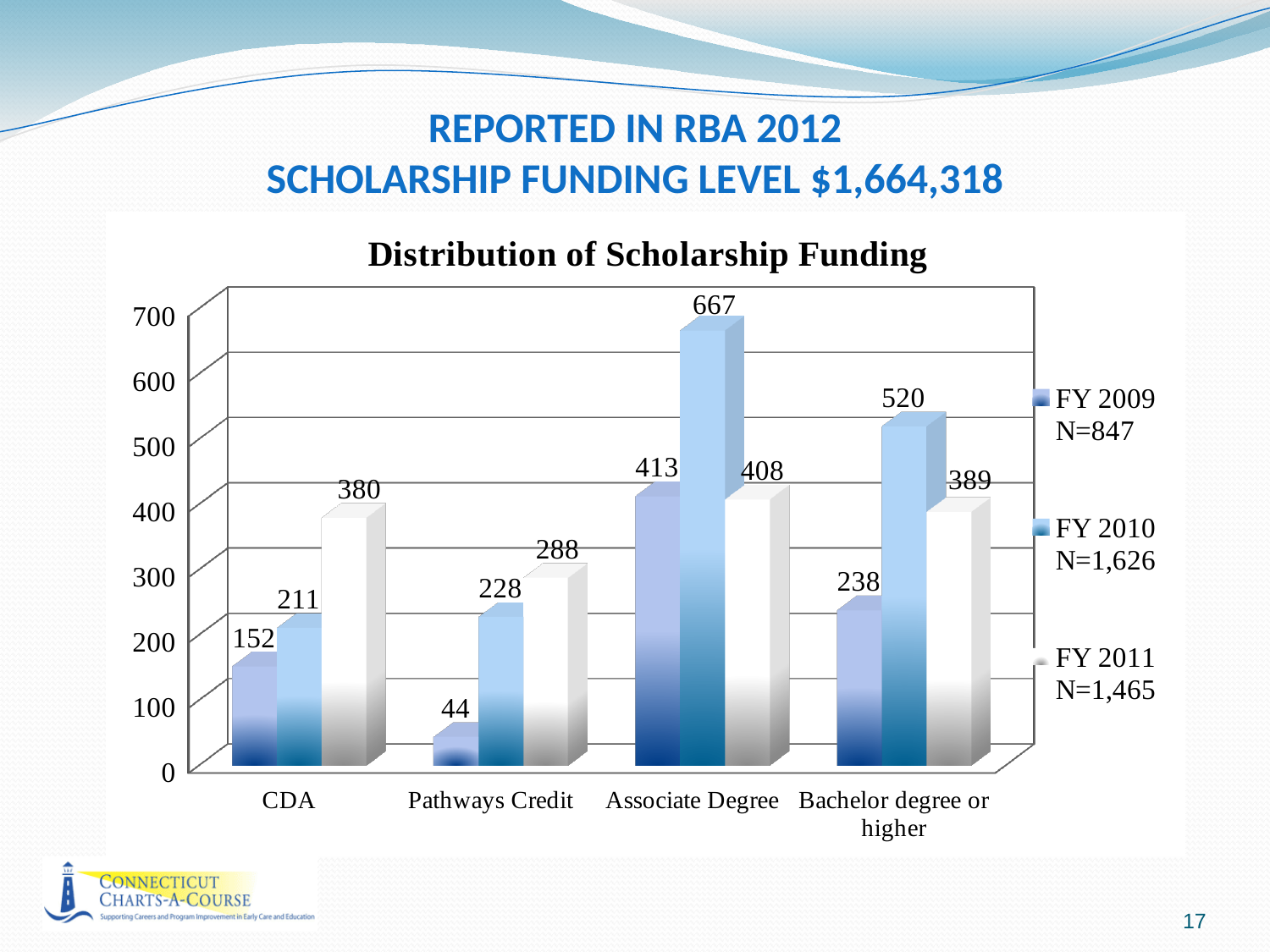
What is the FY 2009 value for Pathways Credit? 44 What is the FY 2010 value for Associate Degree? 667 What kind of chart is shown? bar chart Which is larger for Bachelor degree or higher: the FY 2009 value or the FY 2011 value? FY 2011 How many categories are shown on the x axis? 4 What is the title of the chart? Distribution of Scholarship Funding How many series does the legend list? 3 What is the difference between the FY 2010 and FY 2009 values for Associate Degree? 254 What is the FY 2011 value for CDA? 380 What is the FY 2010 value for Bachelor degree or higher? 520 Which category has the lowest FY 2011 value? Pathways Credit Which category has the highest FY 2009 value? Associate Degree